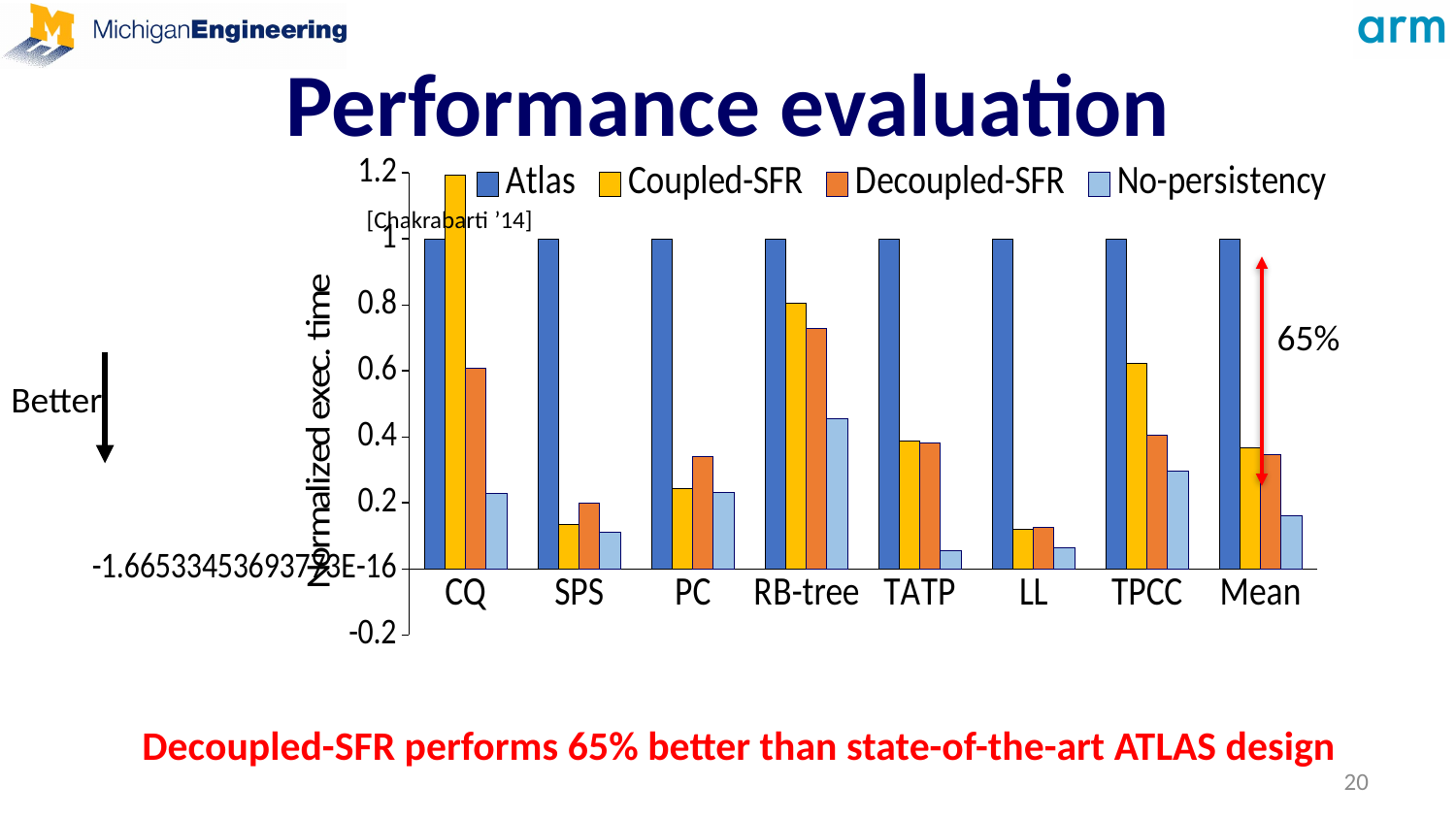
Is the Decoupled-SFR value for Mean greater or less than 0.4? less What percentage is shown next to the red arrow on the Mean bars? 65% What is the normalized exec. time for Atlas in the CQ category? 1 Which category has the highest Coupled-SFR value? CQ What is the normalized exec. time for Atlas in the Mean category? 1 For the PC category, which is larger: Coupled-SFR or Decoupled-SFR? Decoupled-SFR How many categories are shown on the x axis? 8 How many series does the legend list? 4 Is the Coupled-SFR value for CQ greater or less than 1? greater Is the Decoupled-SFR value for RB-tree greater or less than 0.6? greater What kind of chart is shown on the slide? bar chart